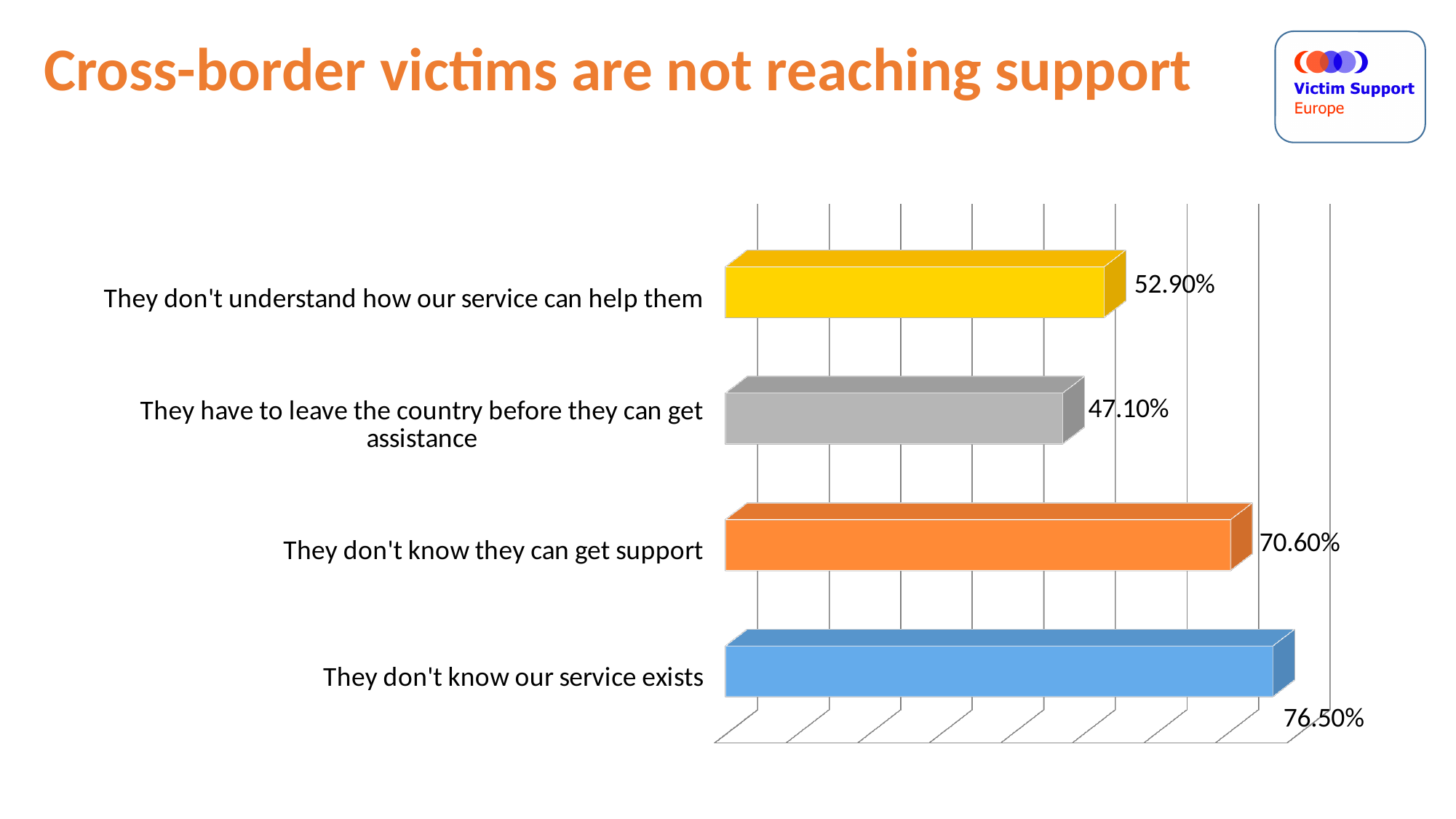
Which category has the lowest value? They have to leave the country before they can get assistance What is the difference between the values for "They don't know our service exists" and "They don't know they can get support"? 5.90% What is the difference between the values for "They don't understand how our service can help them" and "They have to leave the country before they can get assistance"? 5.80% What colour is the bar for "They don't know they can get support"? Orange What percentage is shown for "They don't know our service exists"? 76.50% Which is larger: the value for "They don't understand how our service can help them" or for "They have to leave the country before they can get assistance"? They don't understand how our service can help them What percentage is shown for "They have to leave the country before they can get assistance"? 47.10% How many categories are shown in the chart? 4 What value is shown for "They don't understand how our service can help them"? 52.90% Which category has the highest value? They don't know our service exists What kind of chart is shown on the slide? Bar chart What value is shown for "They don't know they can get support"? 70.60%